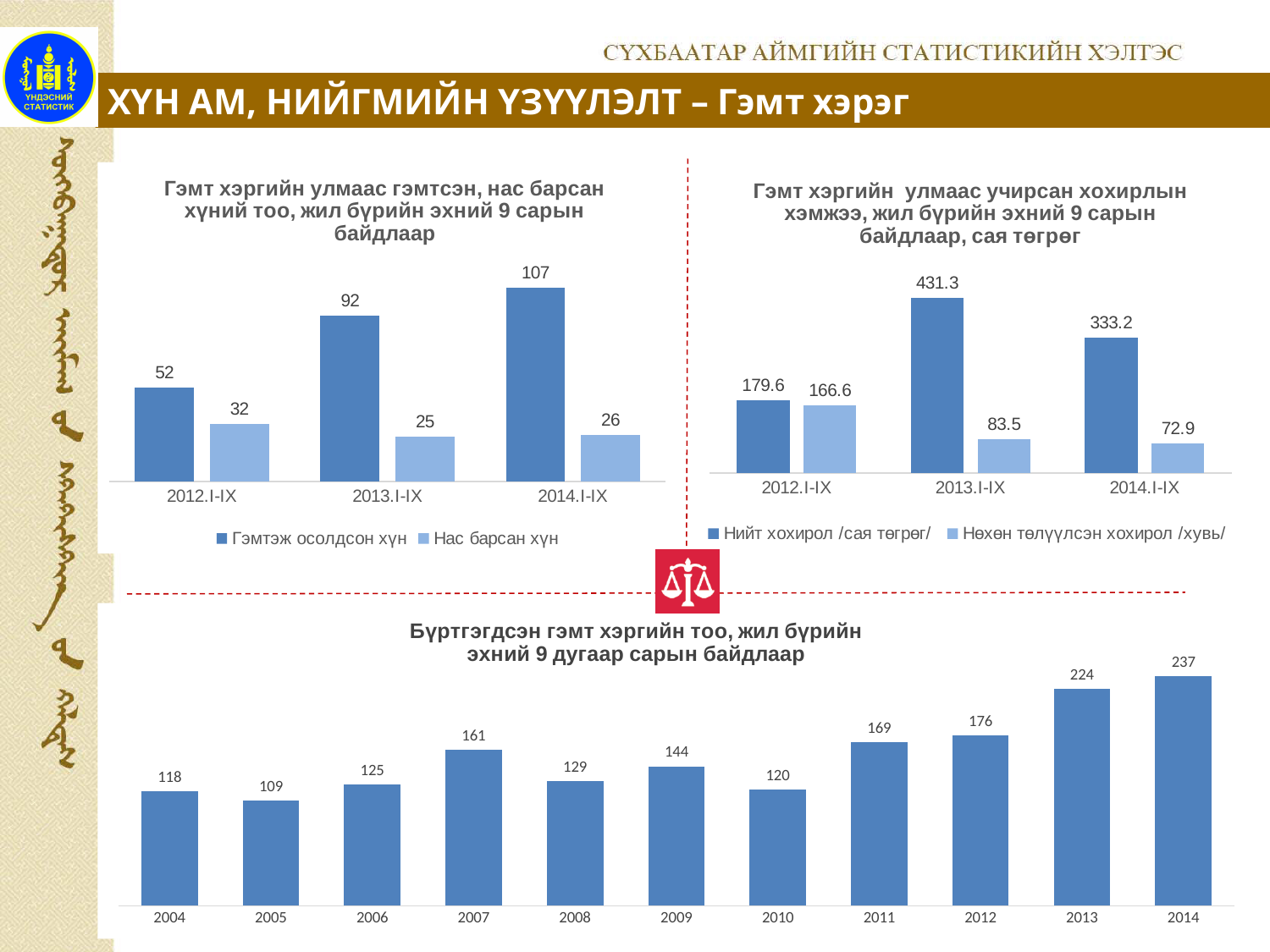
In the top-left chart, what is the difference between Гэмтэж осолдсон хүн and Нас барсан хүн in 2014.I-IX? 81 In the top-left chart, how many series does the legend list? 2 In the top-right chart, which period has the lowest value for Нөхөн төлүүлсэн хохирол? 2014.I-IX In the top-right chart, which is larger in 2012.I-IX: Нийт хохирол or Нөхөн төлүүлсэн хохирол? Нийт хохирол In the bottom chart, which year has the highest value? 2014 In the bottom chart, how many years are shown on the x axis? 11 In the bottom chart, what is the value for 2007? 161 In the top-left chart, what is the value for Гэмтэж осолдсон хүн in 2013.I-IX? 92 In the top-right chart, what is the value for Нийт хохирол in 2013.I-IX? 431.3 In the top-left chart, what is the value for Нас барсан хүн in 2012.I-IX? 32 In the top-right chart, what is the value for Нөхөн төлүүлсэн хохирол in 2014.I-IX? 72.9 What kind of chart is the bottom chart? bar chart